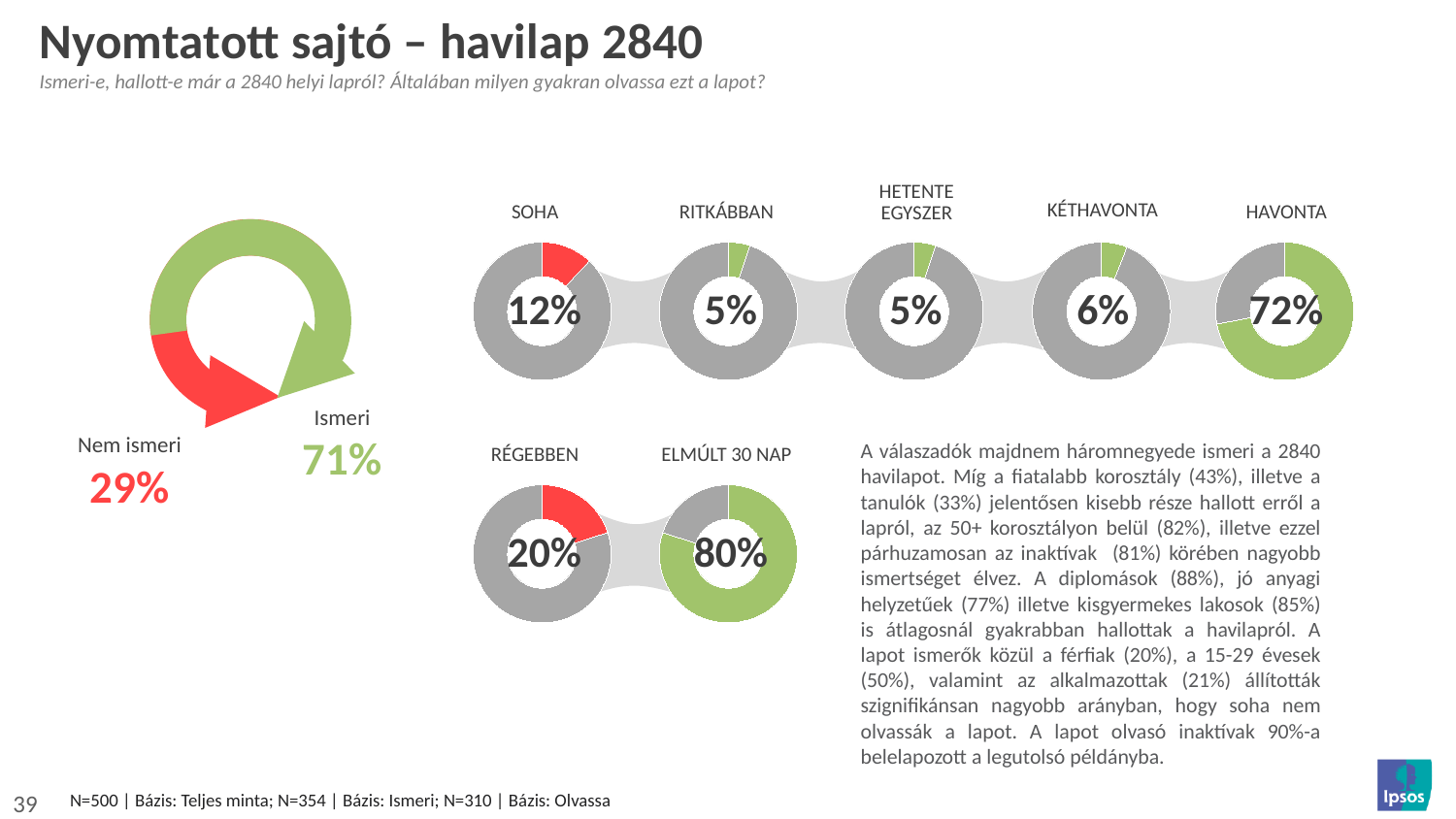
In the row of five donut charts at the top right, which category has the highest percentage? HAVONTA In the row of five donut charts at the top right, what percentage is shown for "KÉTHAVONTA"? 6% In the row of five donut charts at the top right, which is larger: the value for "SOHA" or the value for "KÉTHAVONTA"? SOHA What type of chart is used to show the "Ismeri" and "Nem ismeri" shares on the left of the slide? Donut chart In the two donut charts at the bottom centre, what percentage is shown for "ELMÚLT 30 NAP"? 80% In the large donut chart on the left, what percentage is shown for "Ismeri"? 71% In the large donut chart on the left, what percentage is shown for "Nem ismeri"? 29% In the row of five donut charts at the top right, what percentage is shown for "HAVONTA"? 72% In the row of five donut charts at the top right, what percentage is shown for "SOHA"? 12% In the two donut charts at the bottom centre, what percentage is shown for "RÉGEBBEN"? 20% In the large donut chart on the left, what is the difference between the "Ismeri" and "Nem ismeri" percentages? 42% How many donut charts are in the row at the top right of the slide? 5